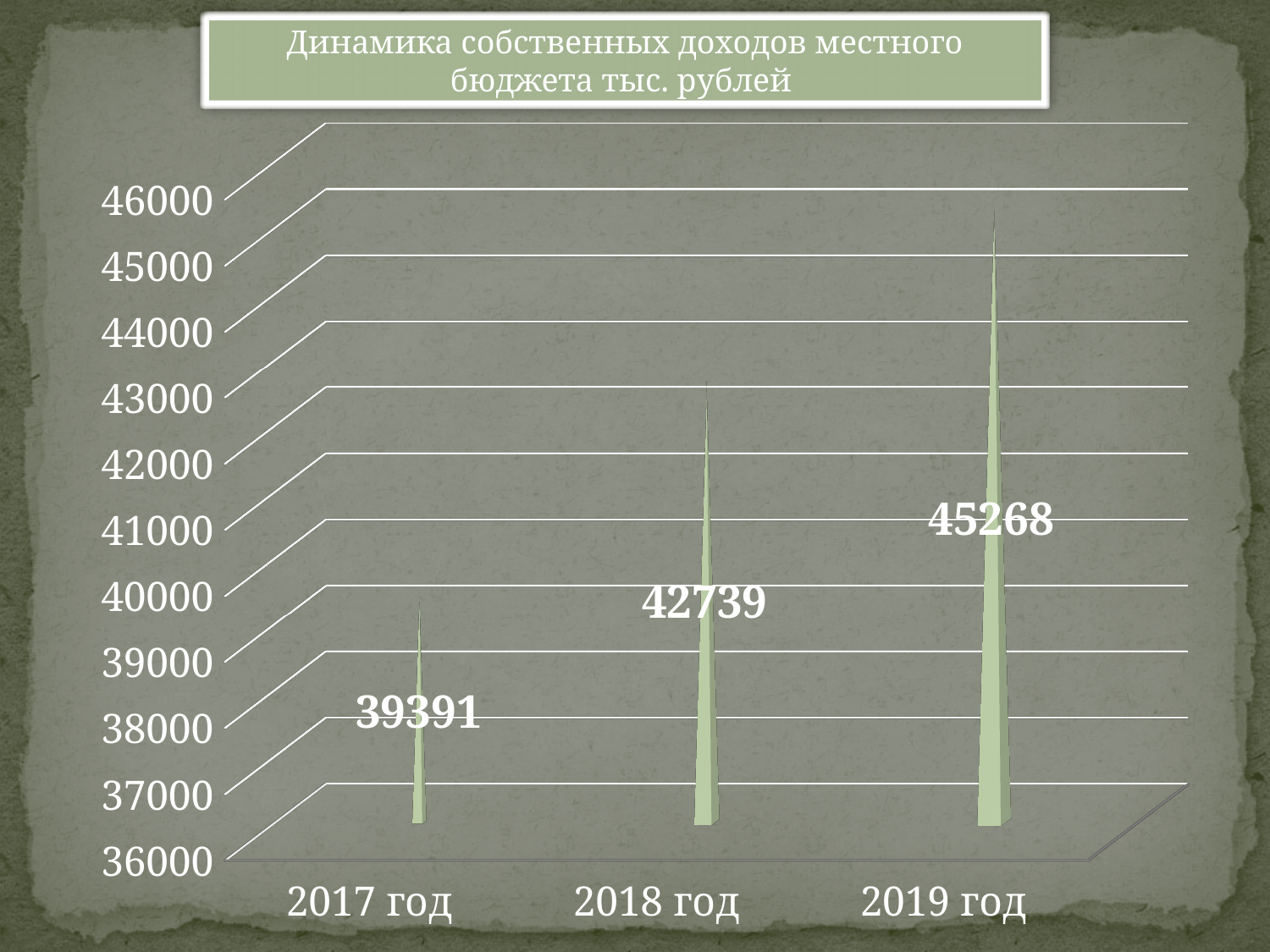
What is the value for 2017 год? 39391 What is the difference between the values for 2019 год and 2017 год? 5877 How many years are shown on the chart? 3 What is the difference between the values for 2018 год and 2017 год? 3348 What is the value for 2018 год? 42739 Which year has the highest value? 2019 год Which is larger, the value for 2018 год or the value for 2019 год? 2019 год What kind of chart is this? bar chart What is the value for 2019 год? 45268 Do the values rise or fall from 2017 год to 2019 год? rise What is the title of the chart? Динамика собственных доходов местного бюджета тыс. рублей Which year has the lowest value? 2017 год